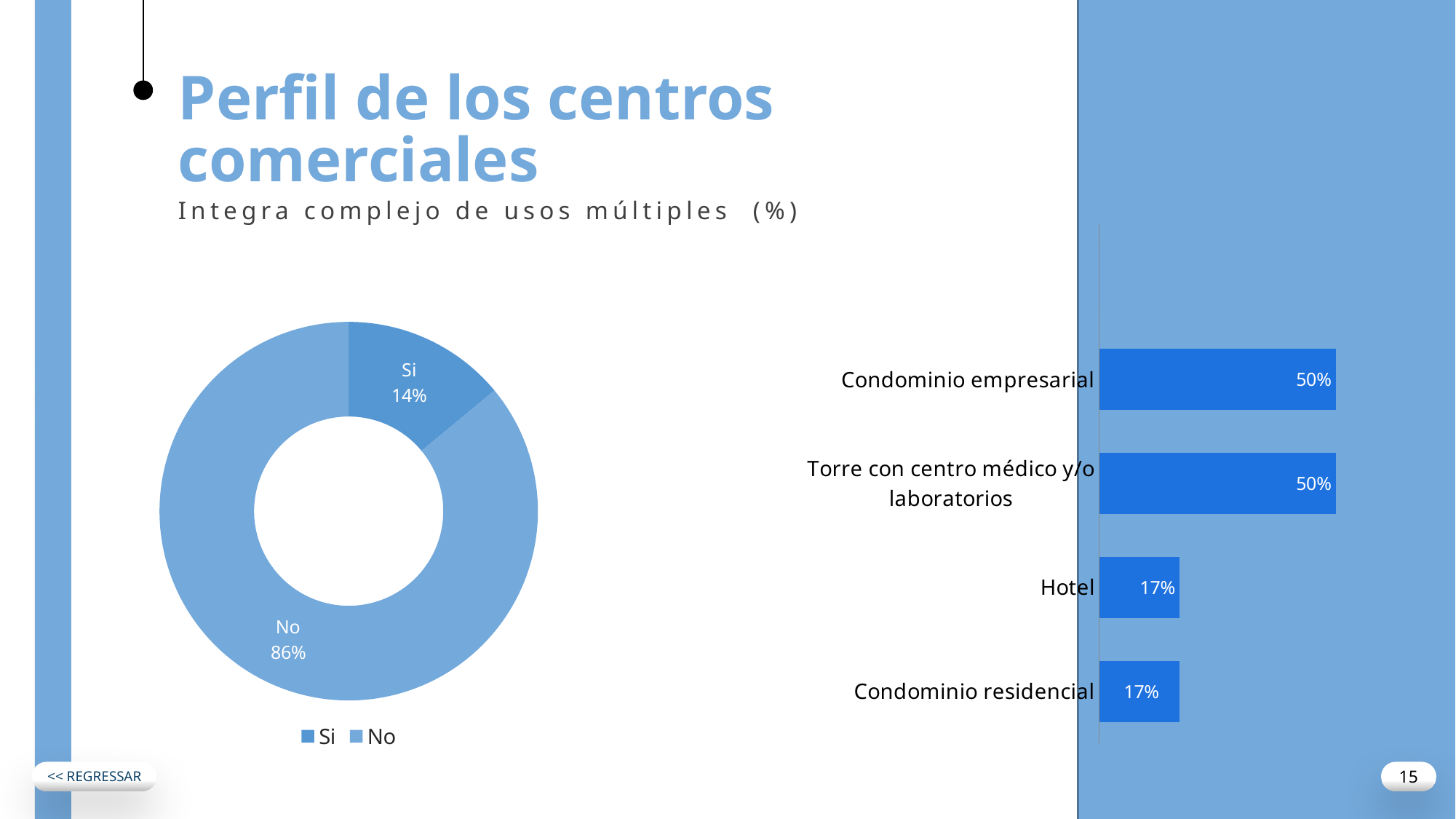
In the bar chart on the right, what is the value for "Hotel"? 17% In the doughnut chart on the left, what percentage is shown for "Si"? 14% In the bar chart on the right, what is the value for "Torre con centro médico y/o laboratorios"? 50% In the doughnut chart on the left, what percentage is shown for "No"? 86% In the bar chart on the right, how many categories are plotted? 4 What kind of chart is shown on the right of the slide? Bar chart In the bar chart on the right, what is the difference between "Condominio empresarial" and "Condominio residencial"? 33 percentage points In the doughnut chart on the left, what is the difference in percentage points between "No" and "Si"? 72 How many entries does the legend of the doughnut chart on the left list? 2 In the bar chart on the right, what is the value for "Condominio empresarial"? 50% What kind of chart is shown on the left of the slide? Doughnut (pie) chart In the doughnut chart on the left, which slice is larger, "Si" or "No"? No